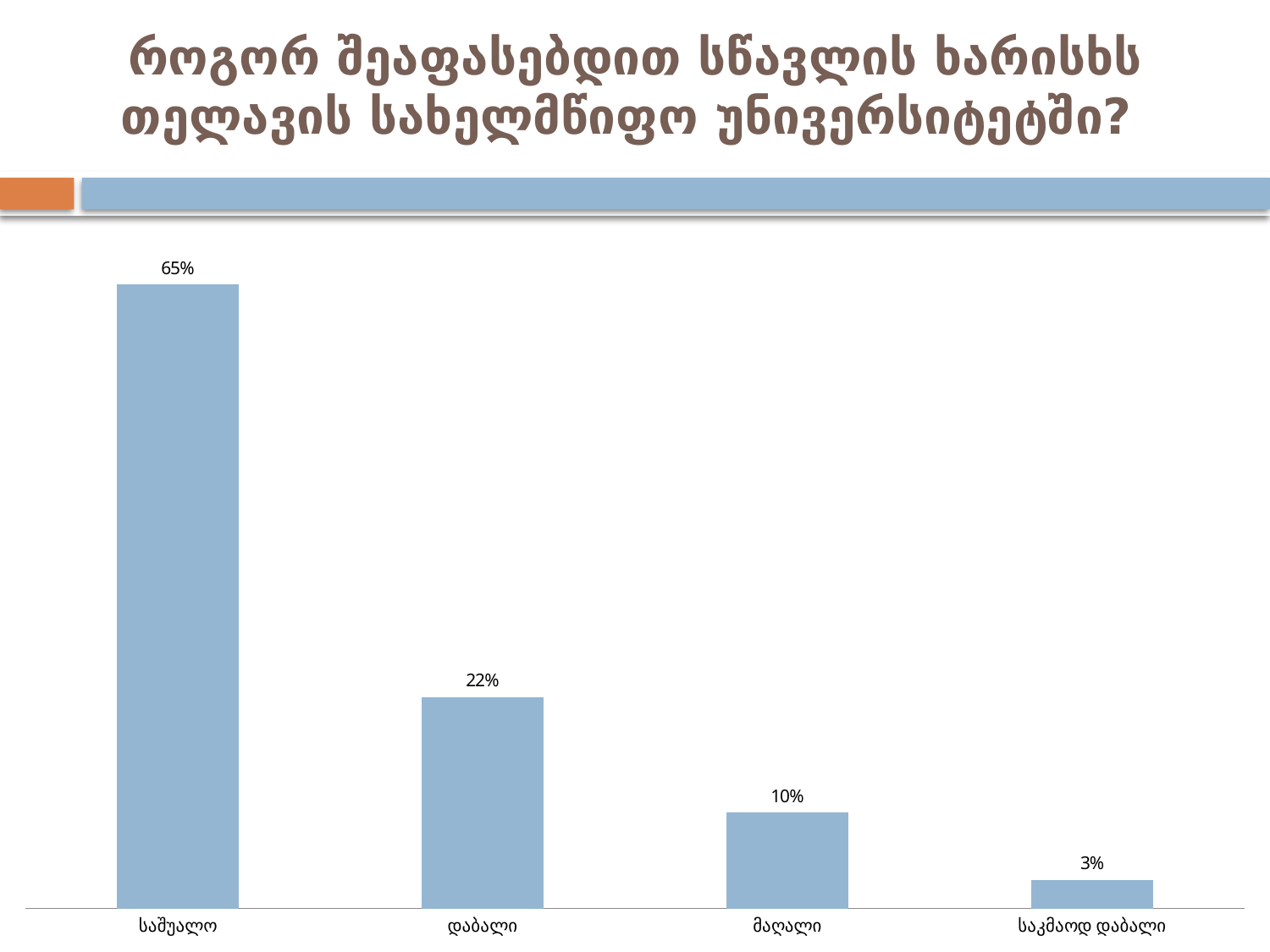
Which is larger, the value for დაბალი or the value for მაღალი? დაბალი Which category has the highest value? საშუალო How many categories are shown in the chart? 4 Which category has the lowest value? საკმაოდ დაბალი What is the value for საშუალო? 65% What is the difference between the values for საშუალო and დაბალი? 43% What is the difference between the values for მაღალი and საკმაოდ დაბალი? 7% What kind of chart is shown on the slide? bar chart What is the value for საკმაოდ დაბალი? 3% Do the values rise or fall from left to right across the categories? fall What is the value for მაღალი? 10% What is the value for დაბალი? 22%